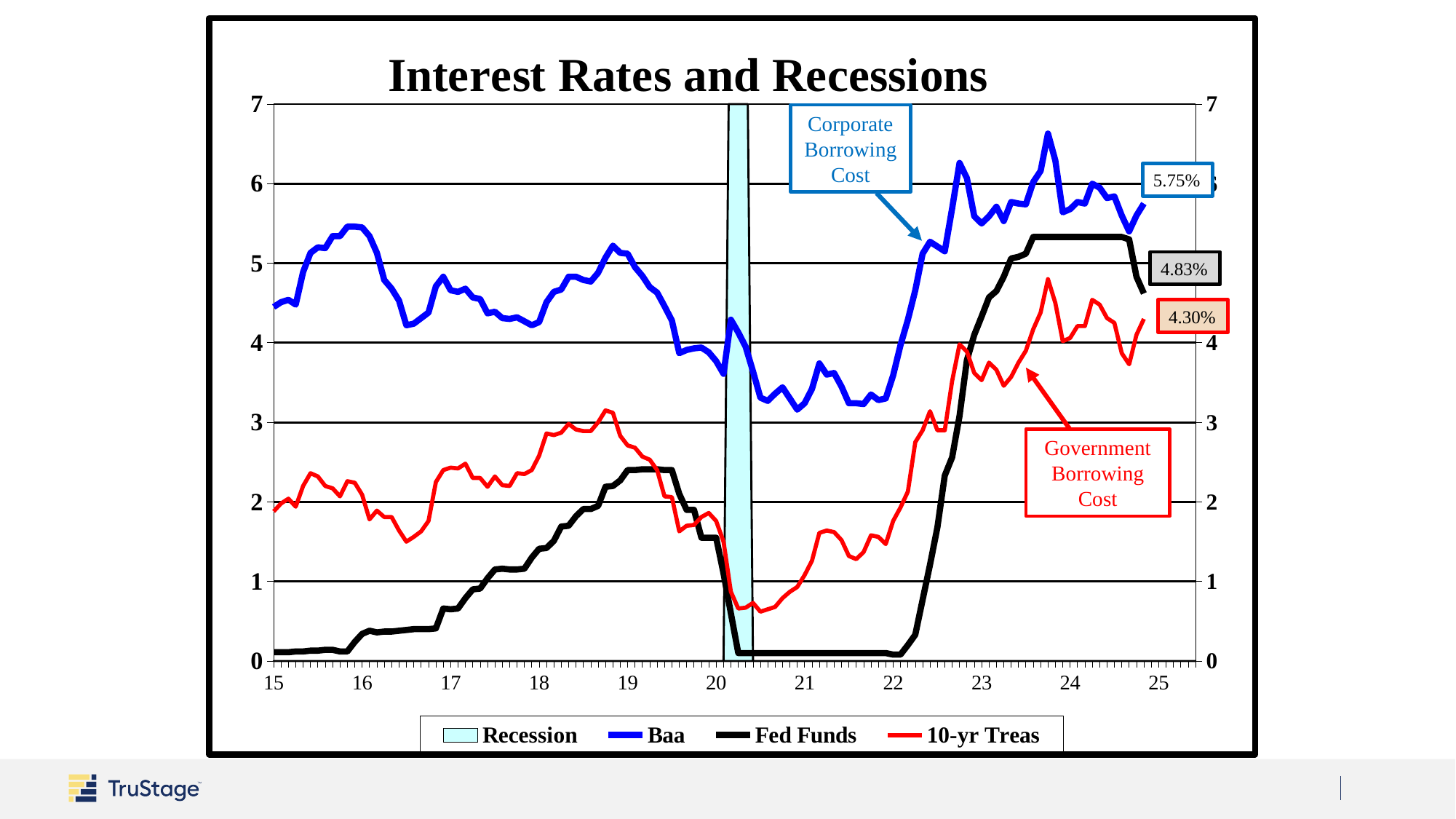
Which series is annotated as the 'Government Borrowing Cost'? 10-yr Treas What is the difference between the latest labeled Baa value and the latest labeled Fed Funds value? 0.92% What kind of chart is shown on the slide? line chart What is the title of the chart? Interest Rates and Recessions How many entries does the chart's legend list? 4 What is the latest labeled value for the Baa series? 5.75% What is the latest labeled value for the 10-yr Treas series? 4.30% Which series has the highest latest labeled value? Baa What is the difference between the latest labeled Baa value and the latest labeled 10-yr Treas value? 1.45% Does the Fed Funds rate rise or fall between 22 and 23 on the x axis? rise What is the latest labeled value for the Fed Funds series? 4.83% Is the Fed Funds rate during 2021 greater or less than 1? less